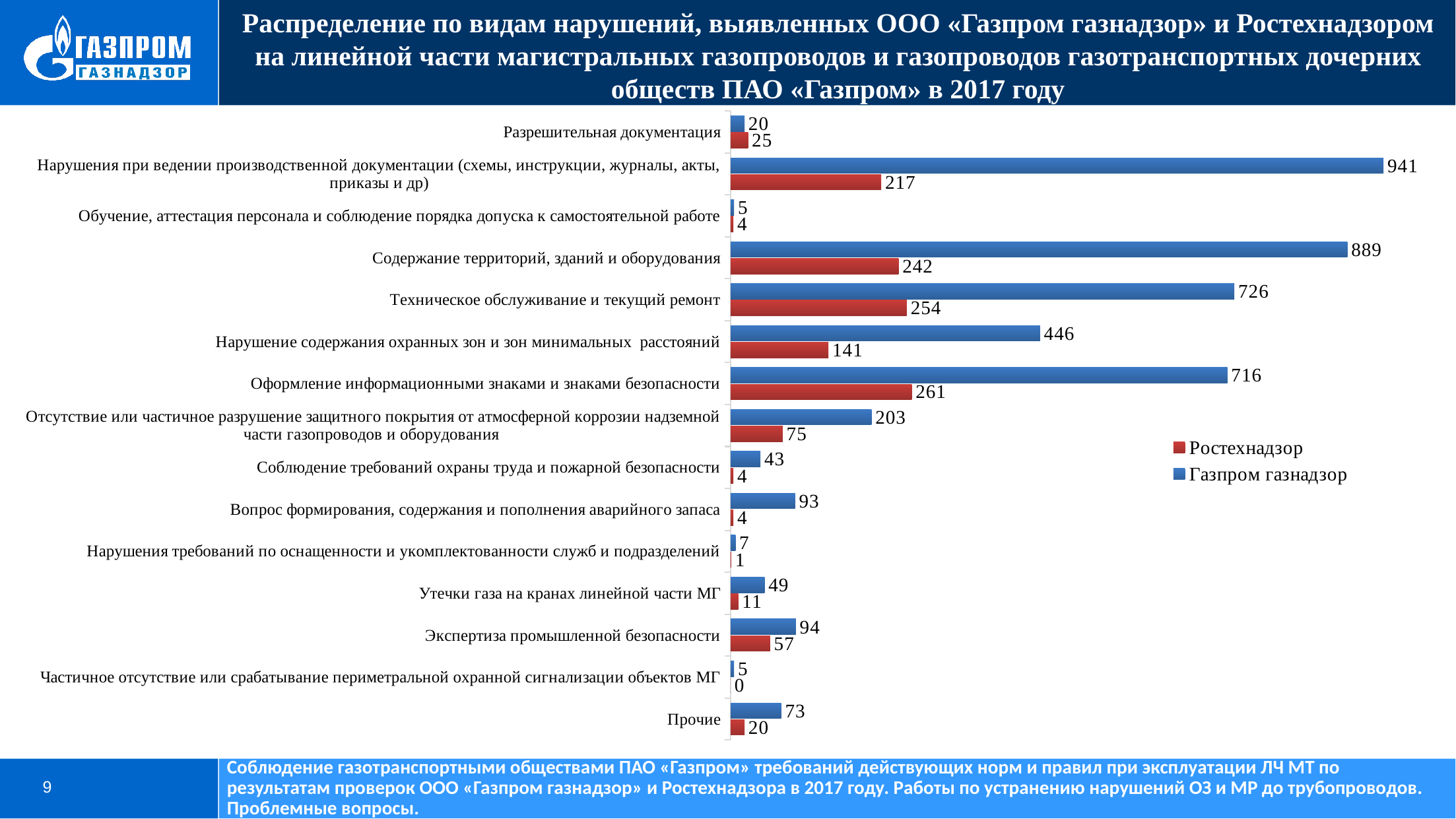
How many categories of violations are shown in the chart? 15 Which colour represents Ростехнадзор in the chart? red What is the value for Ростехнадзор in the category «Экспертиза промышленной безопасности»? 57 What is the value for Газпром газнадзор in the category «Техническое обслуживание и текущий ремонт»? 726 Which category has the lowest value for Ростехнадзор? Частичное отсутствие или срабатывание периметральной охранной сигнализации объектов МГ What type of chart is shown on the slide? bar chart In the category «Разрешительная документация», which series has the larger value: Ростехнадзор or Газпром газнадзор? Ростехнадзор Which category has the highest value for Ростехнадзор? Оформление информационными знаками и знаками безопасности What is the value for Ростехнадзор in the category «Содержание территорий, зданий и оборудования»? 242 Which category has the highest value for Газпром газнадзор? Нарушения при ведении производственной документации (схемы, инструкции, журналы, акты, приказы и др) What is the difference between the Газпром газнадзор and Ростехнадзор values for «Нарушение содержания охранных зон и зон минимальных расстояний»? 305 How many series does the legend list? 2